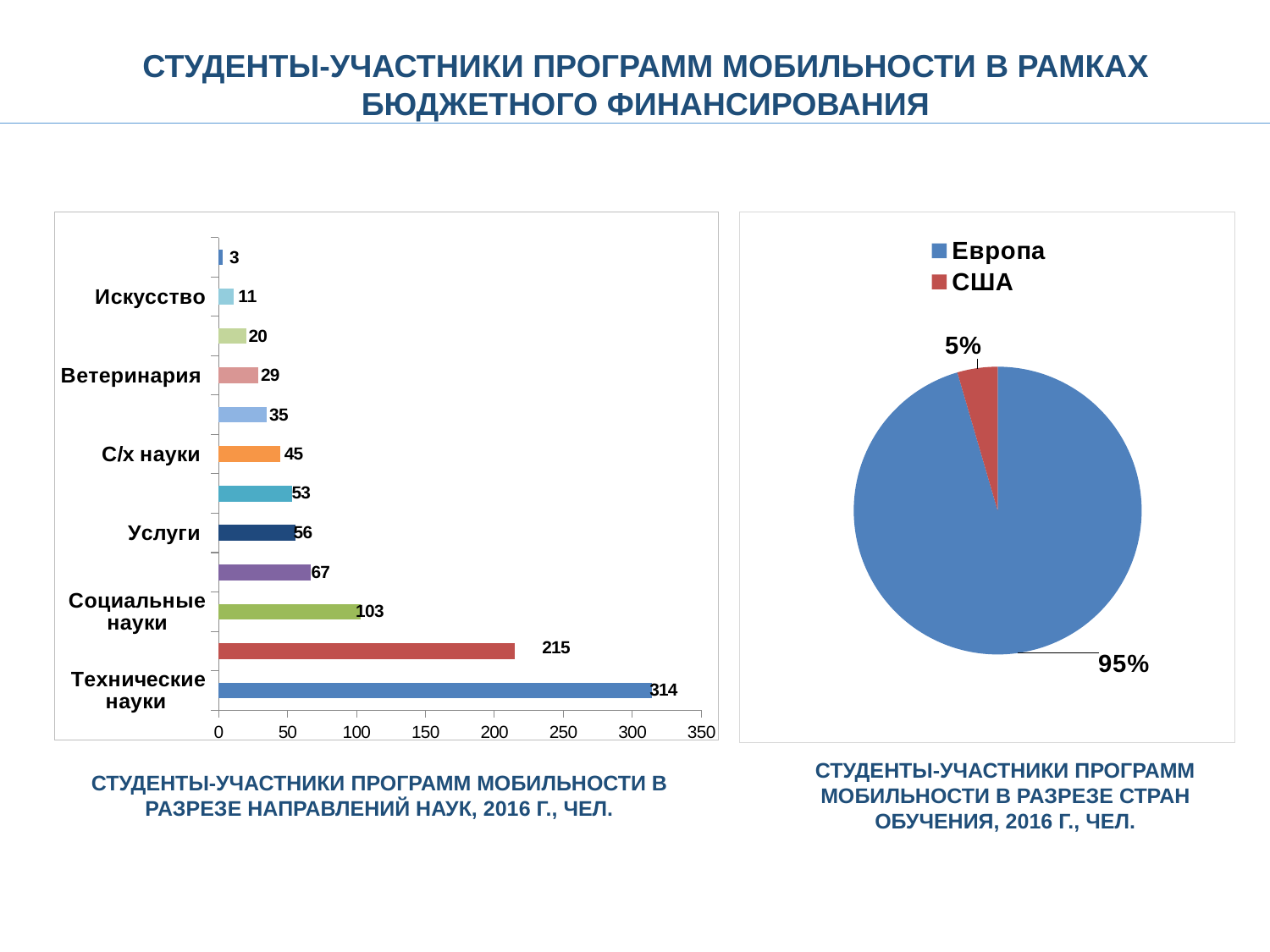
In the left bar chart, which labelled category has the highest value? Технические науки How many entries does the legend of the right pie chart list? 2 In the left bar chart, which is larger: the value for Услуги or the value for С/х науки? Услуги In the left bar chart, how many students are shown for Технические науки? 314 In the left bar chart, what is the value for Искусство? 11 In the left bar chart, which labelled category has the lowest value? Искусство In the right pie chart, what share of students studied in Европа? 95% What type of chart is the chart on the left of the slide? Bar chart In the left bar chart, what is the value for Социальные науки? 103 How many bars are plotted in the left bar chart? 12 In the left bar chart, what is the value for Ветеринария? 29 In the left bar chart, what is the difference between the values for Технические науки and Социальные науки? 211